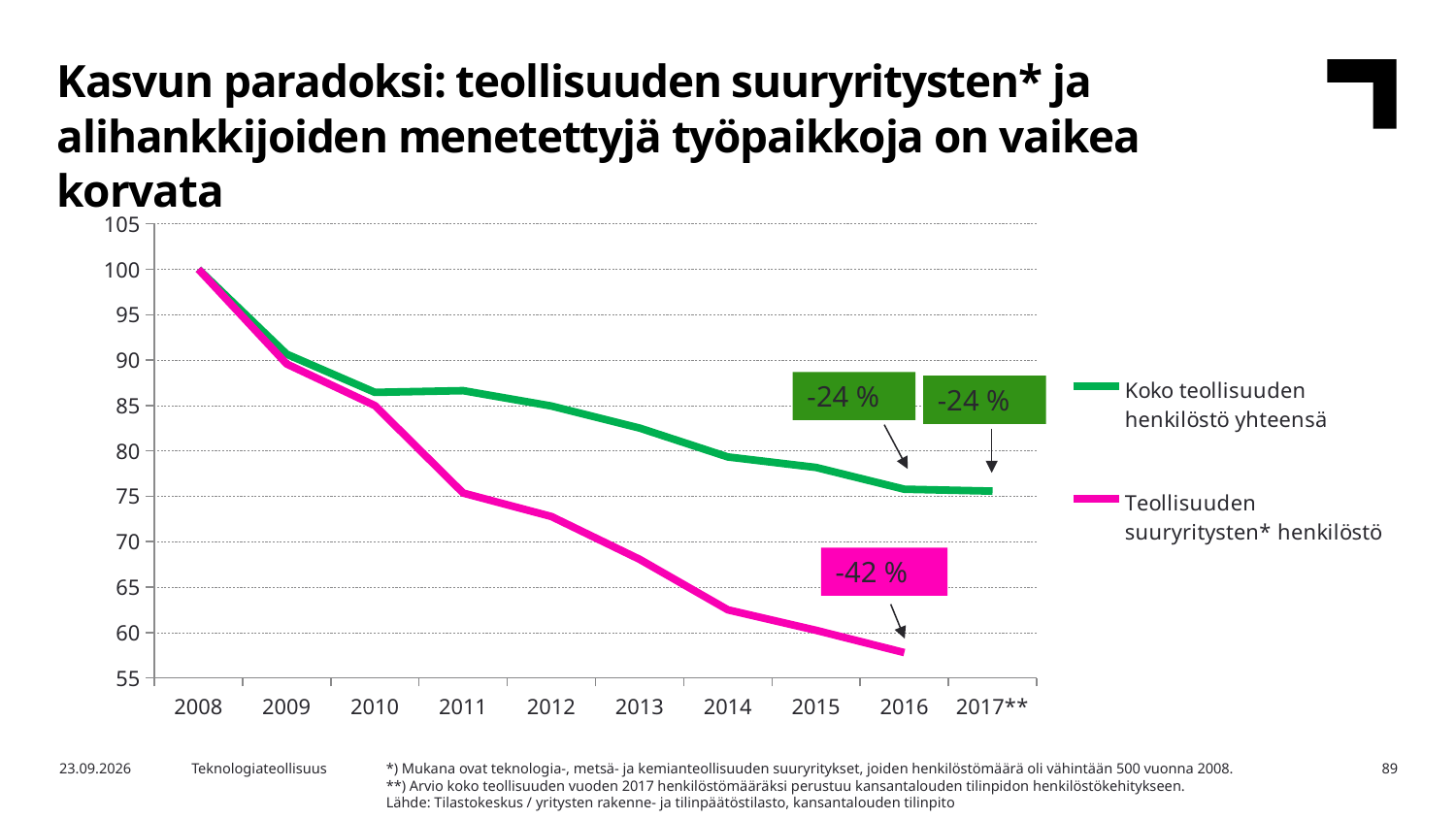
What percentage change is labelled for 'Koko teollisuuden henkilöstö yhteensä' at 2017**? -24 % Is the value for 'Koko teollisuuden henkilöstö yhteensä' in 2016 greater or less than 80? less What is the value of both series in 2008? 100 How many years are shown on the x axis? 10 What colour is the line for 'Teollisuuden suuryritysten* henkilöstö'? Magenta (pink) Do the values for 'Teollisuuden suuryritysten* henkilöstö' rise or fall from 2008 to 2016? Fall What kind of chart is shown on the slide? Line chart Is the value for 'Teollisuuden suuryritysten* henkilöstö' in 2016 greater or less than 60? less Is the value for 'Koko teollisuuden henkilöstö yhteensä' in 2012 greater or less than 80? greater How many series does the legend list? 2 What percentage change is labelled for 'Teollisuuden suuryritysten* henkilöstö' at 2016? -42 % Which series has the higher value in 2016? Koko teollisuuden henkilöstö yhteensä